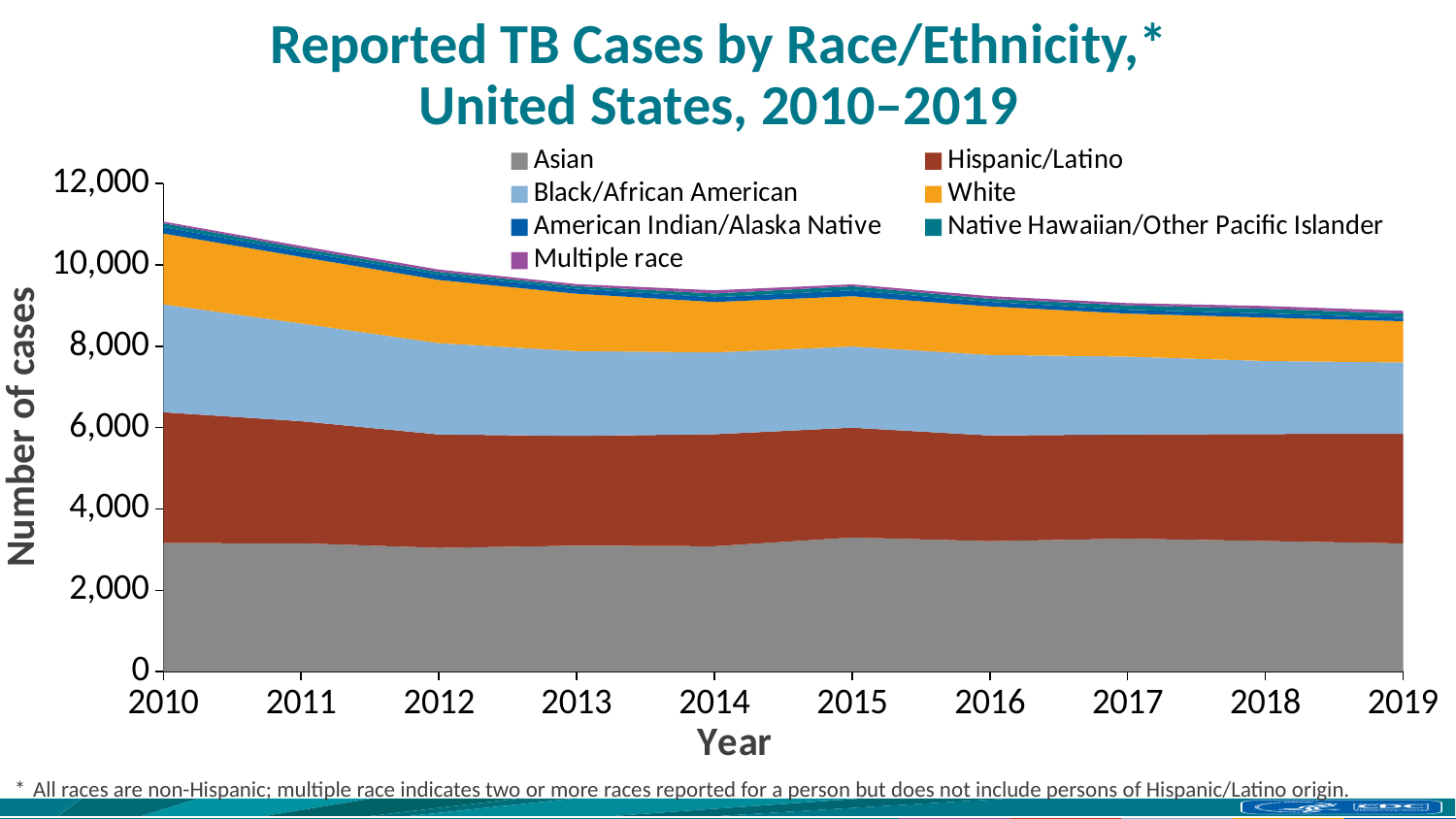
Is the total number of cases in 2010 greater or less than 10,000? greater What is the title of the chart? Reported TB Cases by Race/Ethnicity,* United States, 2010–2019 How many series does the legend list? 7 How many years are shown along the x axis? 10 Which year has the highest total number of reported TB cases? 2010 What kind of chart is shown on the slide? Stacked area chart Is the number of cases for Asian in 2010 greater or less than 2,000? greater What is the label of the y axis? Number of cases Does the total number of reported TB cases rise or fall from 2010 to 2019? Fall In 2019, which group has more cases, Asian or White? Asian In 2010, which group has more cases, Black/African American or White? Black/African American Is the total number of cases in 2019 greater or less than 10,000? less